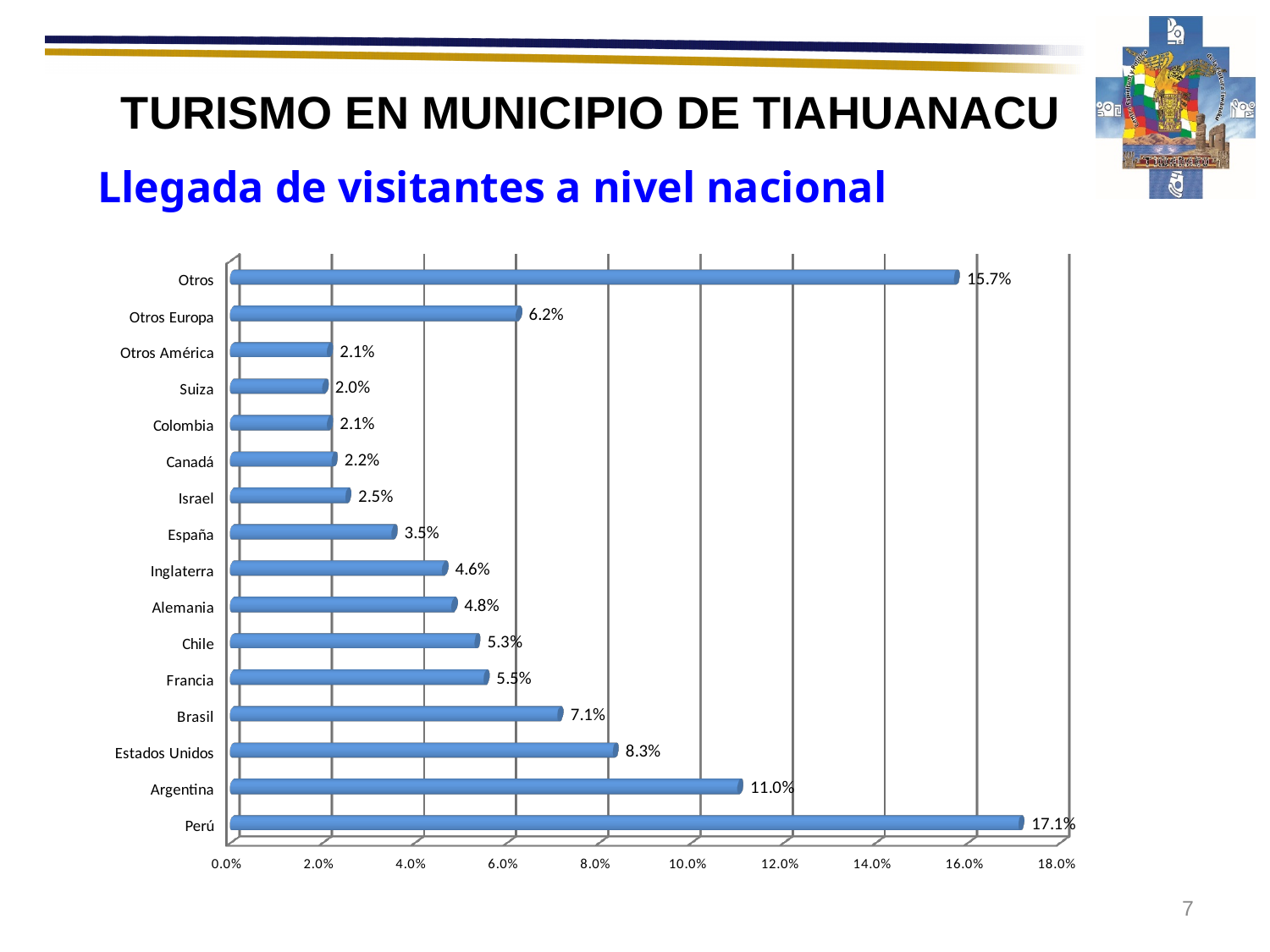
Which category has the lowest value? Suiza What is the value for Perú? 17.1% What is the difference between the values for Perú and Argentina? 6.1% Which category has the highest value? Perú What is the subtitle of the chart shown on the slide? Llegada de visitantes a nivel nacional Which is larger, the value for Brasil or the value for Francia? Brasil What is the difference between the values for Otros and Otros Europa? 9.5% What is the value for Otros Europa? 6.2% Is the value for Argentina greater or less than 10.0%? greater What is the value for Estados Unidos? 8.3% How many categories are shown in the chart? 16 What kind of chart is shown on the slide? bar chart